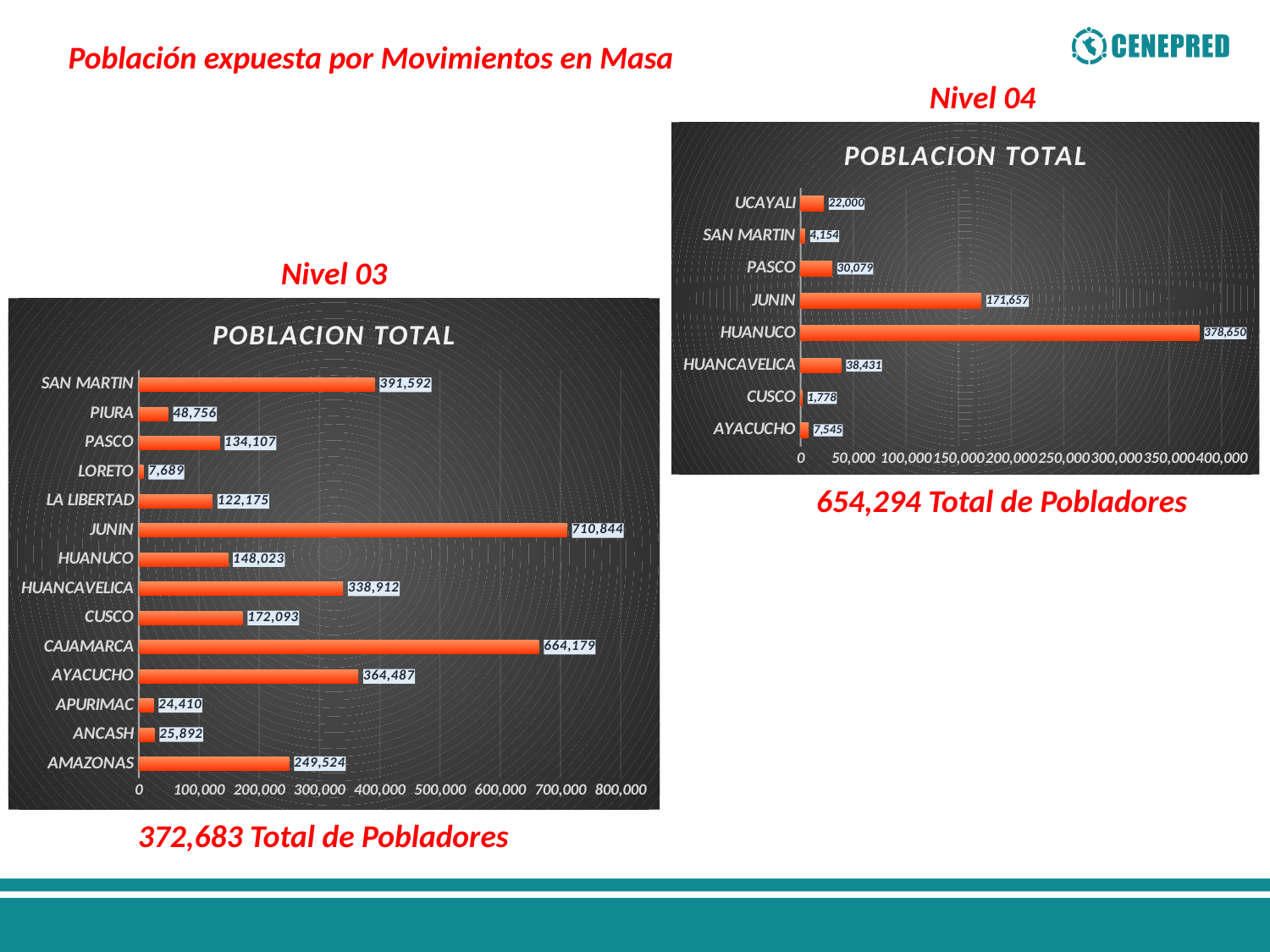
What type of chart is the Nivel 04 chart? Bar chart In the Nivel 04 chart, which category has the lowest value? CUSCO In the Nivel 03 chart, what is the difference between the values for JUNIN and CAJAMARCA? 46,665 How many categories are shown in the Nivel 03 chart? 14 How many categories are shown in the Nivel 04 chart? 8 In the Nivel 03 chart, which is larger, the value for SAN MARTIN or the value for AYACUCHO? SAN MARTIN In the Nivel 04 chart, which category has the highest value? HUANUCO In the Nivel 03 chart, what is the value for HUANCAVELICA? 338,912 In the Nivel 04 chart, what is the value for PASCO? 30,079 In the Nivel 04 chart, what is the difference between the values for HUANUCO and JUNIN? 206,993 In the Nivel 03 chart, what is the value for JUNIN? 710,844 In the Nivel 03 chart, which category has the lowest value? LORETO